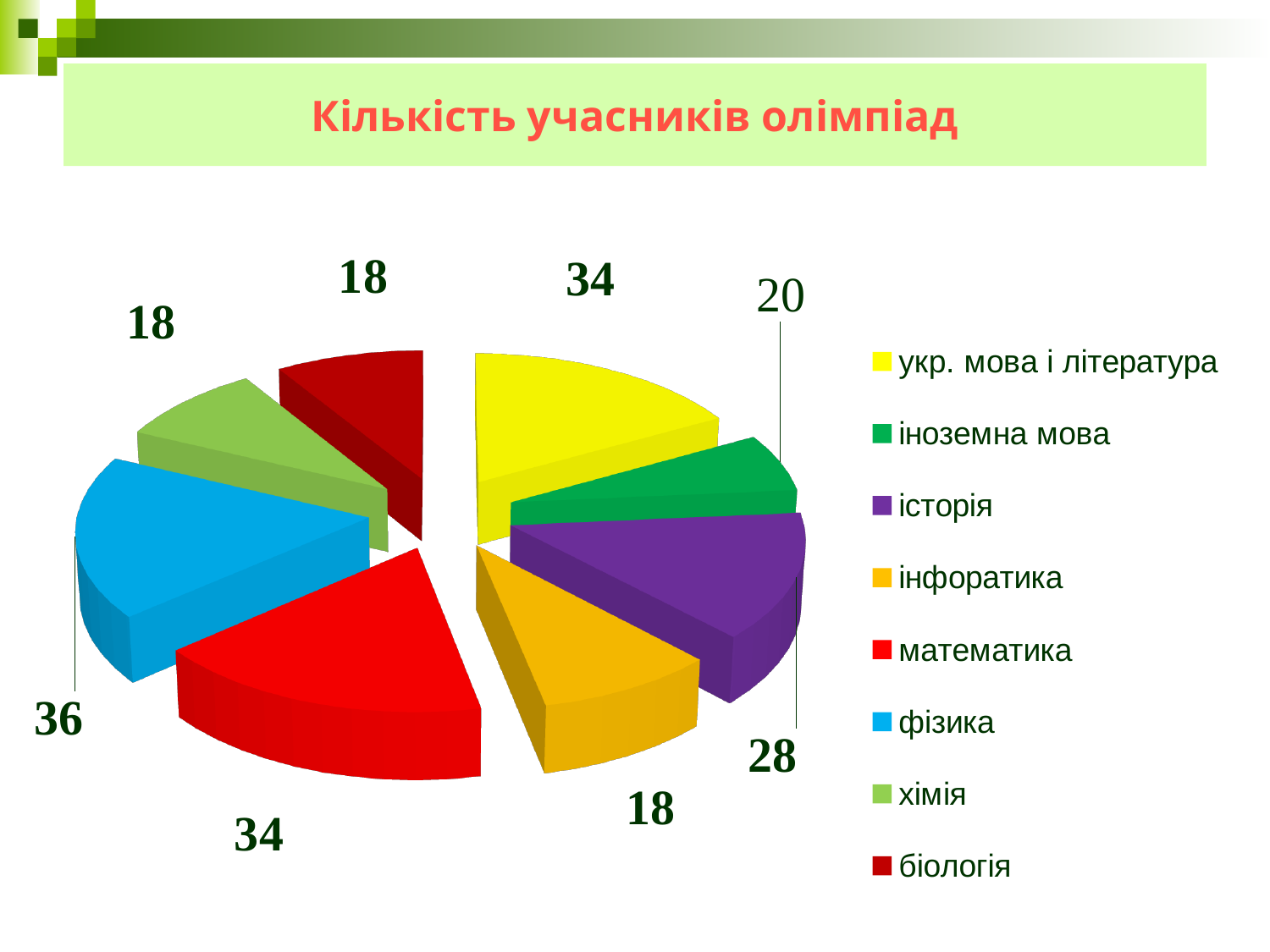
What is the value for фізика? 36 Which category has the highest value? фізика What is the value for історія? 28 What is the value for укр. мова і література? 34 What type of chart is shown on the slide? pie chart What is the title of the chart? Кількість учасників олімпіад How many categories (slices) does the pie chart have? 8 What is the value for інфоратика? 18 What colour is the slice for математика? red Which is larger, the value for фізика or the value for історія? фізика What is the difference between the value for фізика and the value for історія? 8 What is the value for іноземна мова? 20